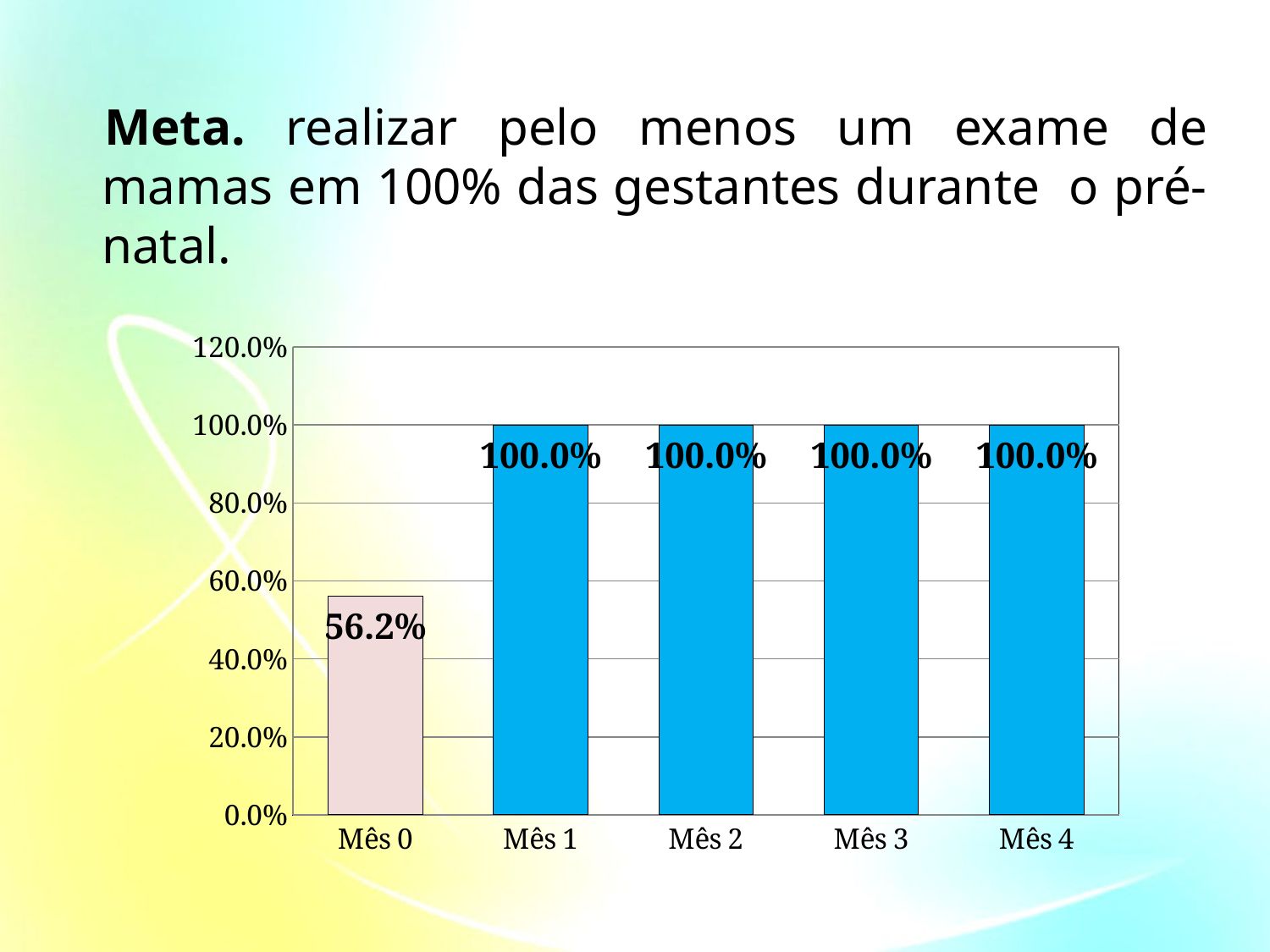
How many categories are shown on the x axis? 5 Which category has the lowest value? Mês 0 What is the value for Mês 2? 100.0% What is the highest tick value shown on the y axis? 120.0% What is the difference between the values for Mês 1 and Mês 0? 43.8% What is the value for Mês 4? 100.0% What kind of chart is shown on the slide? bar chart Is the value for Mês 0 greater or less than 60.0%? less What is the value for Mês 0? 56.2% How many categories have a value of 100.0%? 4 Do the values rise or fall from Mês 0 to Mês 1? rise Which is larger, the value for Mês 0 or the value for Mês 3? Mês 3